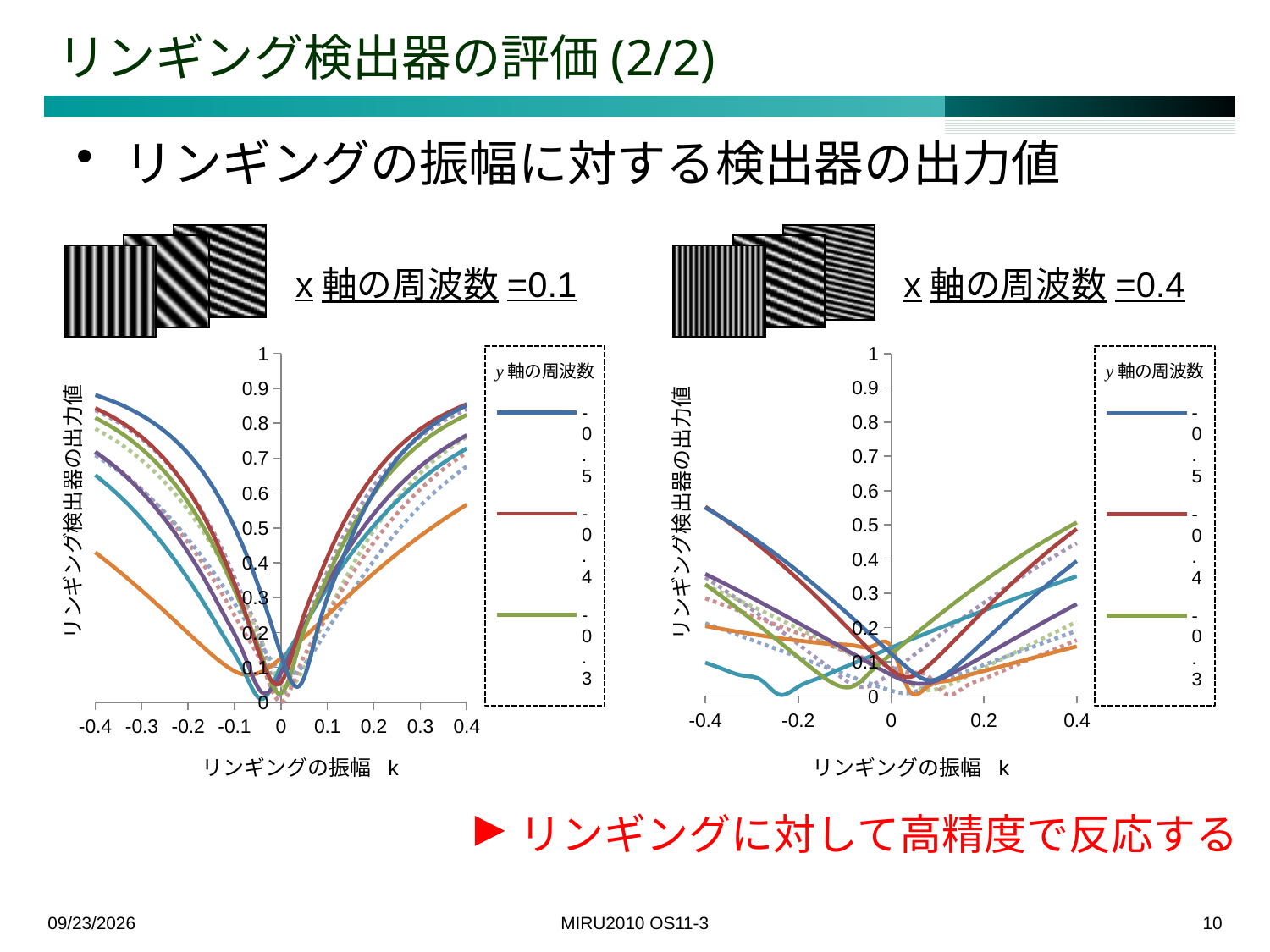
In the right chart (x 軸の周波数 =0.4), is the value of the orange line at k = 0.4 greater or less than 0.2? less What is the title of the legend in the right chart (x 軸の周波数 =0.4)? y 軸の周波数 What kind of chart is the right chart (x 軸の周波数 =0.4)? line chart In the right chart (x 軸の周波数 =0.4), is the value of the solid blue line at k = -0.4 greater or less than 0.5? greater How many tick labels are shown on the x axis of the right chart (x 軸の周波数 =0.4)? 5 In the left chart (x 軸の周波数 =0.1), is the value of the orange line at k = 0.4 greater or less than 0.5? greater In the right chart (x 軸の周波数 =0.4), at k = 0.4, which line has the larger value: the green line or the orange line? the green line What kind of chart is the left chart (x 軸の周波数 =0.1)? line chart In the left chart (x 軸の周波数 =0.1), do the lines rise or fall as k goes from 0 to 0.4? rise In the left chart (x 軸の周波数 =0.1), at k = -0.4, which line has the larger value: the solid blue line or the orange line? the solid blue line What is the x-axis label of the left chart (x 軸の周波数 =0.1)? リンギングの振幅 k